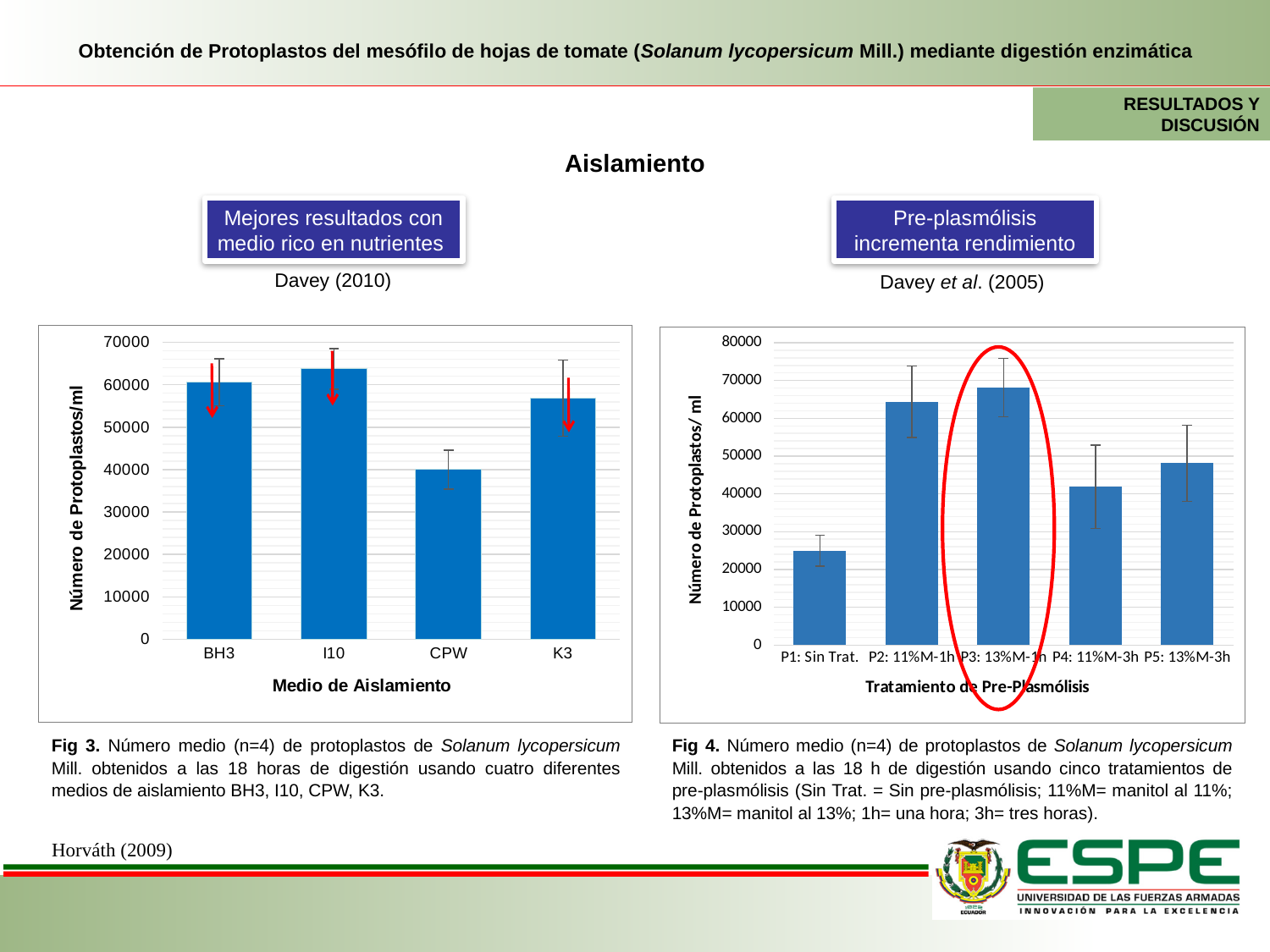
In the left chart (Fig 3), which has a higher number of protoplasts/ml, BH3 or CPW? BH3 In the right chart (Fig 4), is the value for P1: Sin Trat. greater or less than 30000? less In the right chart (Fig 4), how many pre-plasmolysis treatments are plotted? 5 In the right chart (Fig 4), which treatment has the lowest number of protoplasts/ml? P1: Sin Trat. In the left chart (Fig 3), what is the title of the x axis? Medio de Aislamiento In the right chart (Fig 4), is the value for P3: 13%M-1h greater or less than 60000? greater In the right chart (Fig 4), which has a higher number of protoplasts/ml, P2: 11%M-1h or P4: 11%M-3h? P2: 11%M-1h In the left chart (Fig 3), is the value for CPW greater or less than 50000? less In the left chart (Fig 3), how many isolation media are plotted on the x axis? 4 In the left chart (Fig 3), which isolation medium has the lowest number of protoplasts/ml? CPW In the left chart (Fig 3), what kind of chart is shown? bar chart